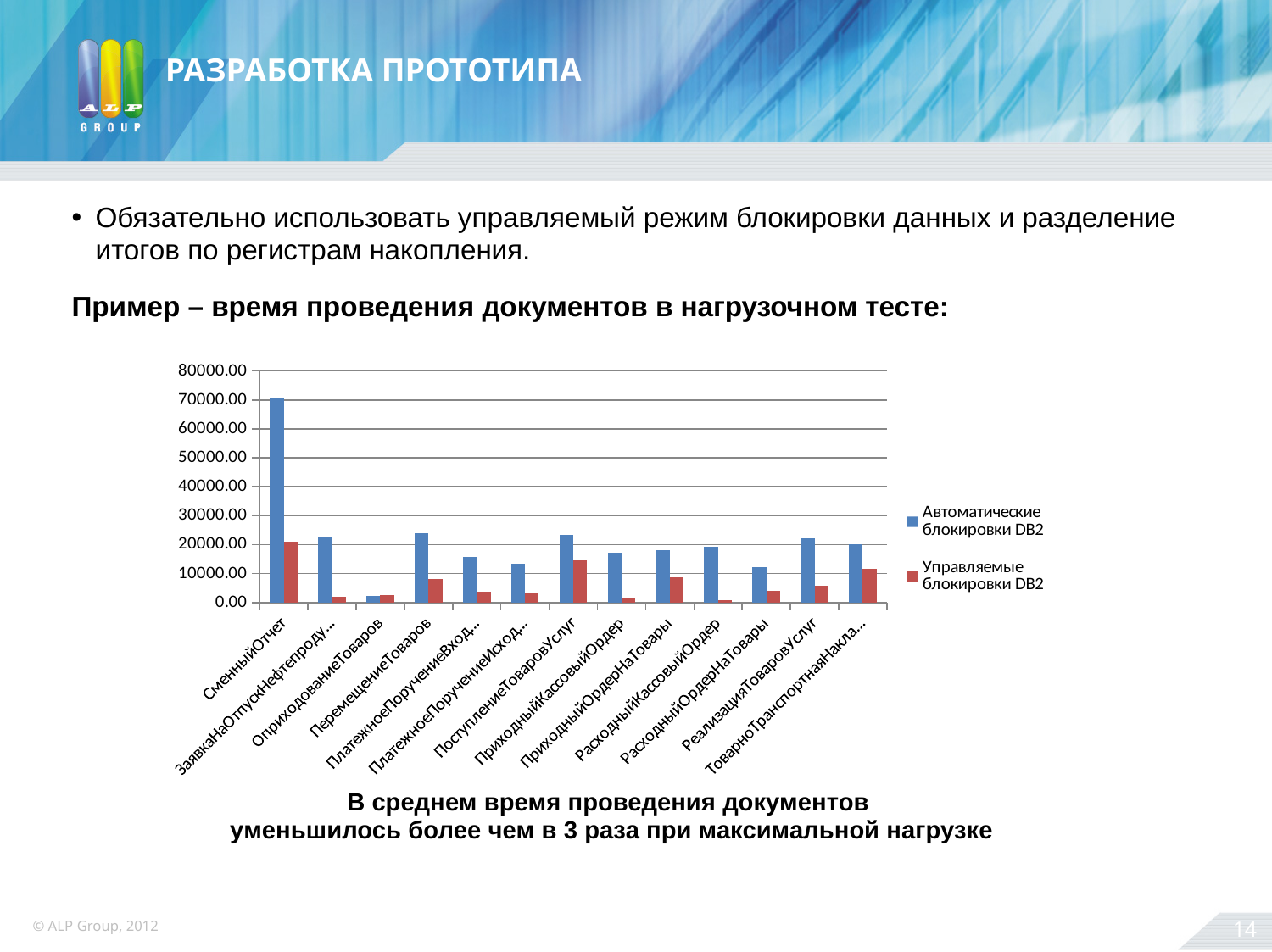
How many document categories are shown on the x axis of the chart? 13 Which colour represents the series Управляемые блокировки DB2 in the chart? red For СменныйОтчет, which series has the larger value: Автоматические блокировки DB2 or Управляемые блокировки DB2? Автоматические блокировки DB2 Which category has the highest value for the series Управляемые блокировки DB2? СменныйОтчет Is the value for СменныйОтчет in the series Автоматические блокировки DB2 greater or less than 60000.00? greater Is the value for ПеремещениеТоваров in the series Автоматические блокировки DB2 greater or less than 20000.00? greater Is the value for РасходныйКассовыйОрдер in the series Управляемые блокировки DB2 greater or less than 10000.00? less How many series does the chart legend list? 2 Which category has the highest value for the series Автоматические блокировки DB2? СменныйОтчет What kind of chart is shown on the slide? bar chart Which category has the lowest value for the series Автоматические блокировки DB2? ОприходованиеТоваров